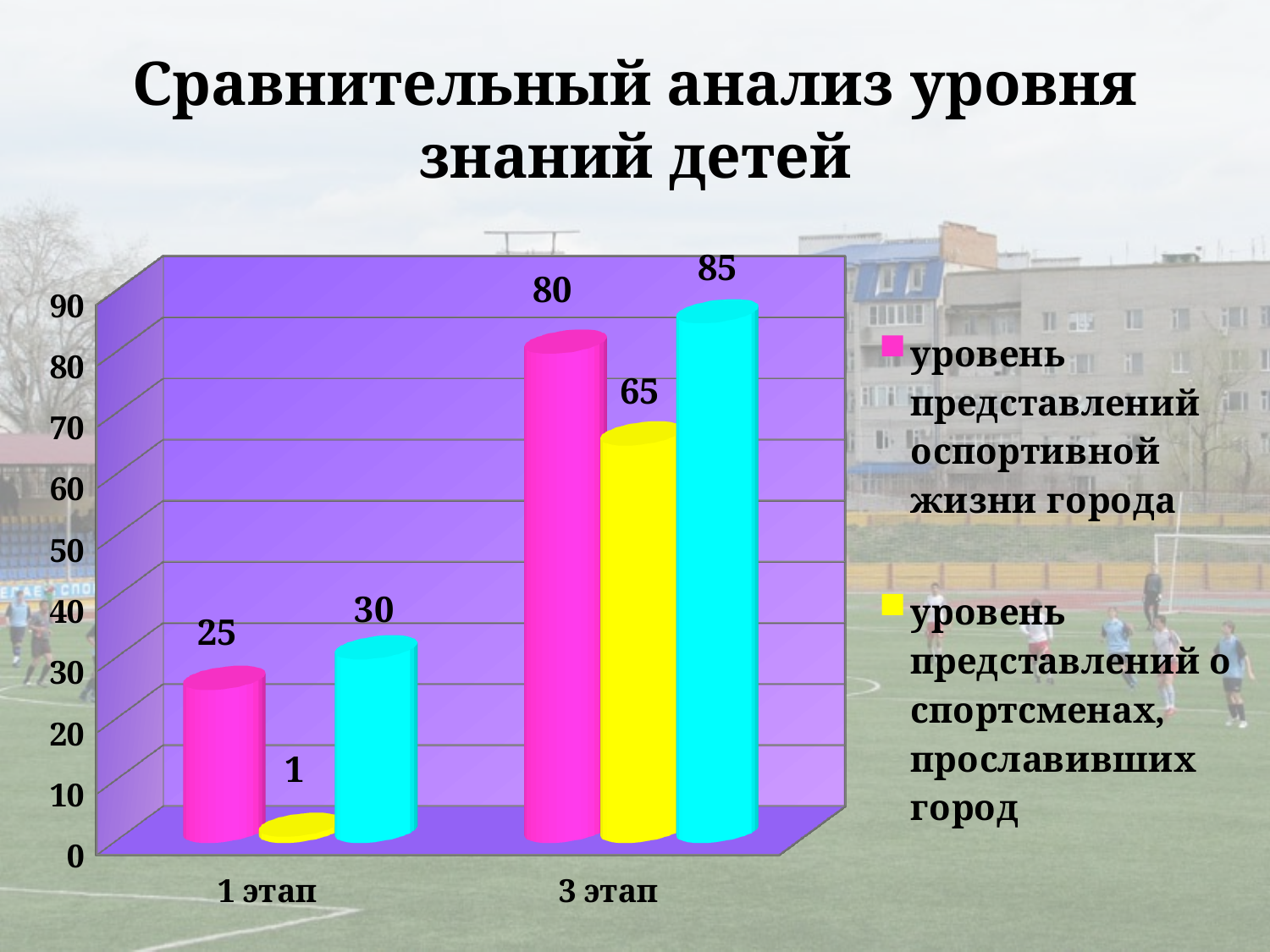
What kind of chart is shown on the slide? bar chart How many series does the legend list? 2 Which is larger for '3 этап': the pink bar or the yellow bar? the pink bar (80) How many categories are shown on the x axis? 2 By how much does the 'уровень представлений о спортивной жизни города' value increase from '1 этап' to '3 этап'? 55 Do the values rise or fall from '1 этап' to '3 этап'? rise What is the value of the 'уровень представлений о спортивной жизни города' series for '1 этап'? 25 What value is labelled on the cyan bar for '1 этап'? 30 What is the lowest value labelled on the chart? 1 What is the value of the 'уровень представлений о спортивной жизни города' series for '3 этап'? 80 What is the value of the 'уровень представлений о спортсменах, прославивших город' series for '3 этап'? 65 What is the highest value labelled on the chart? 85